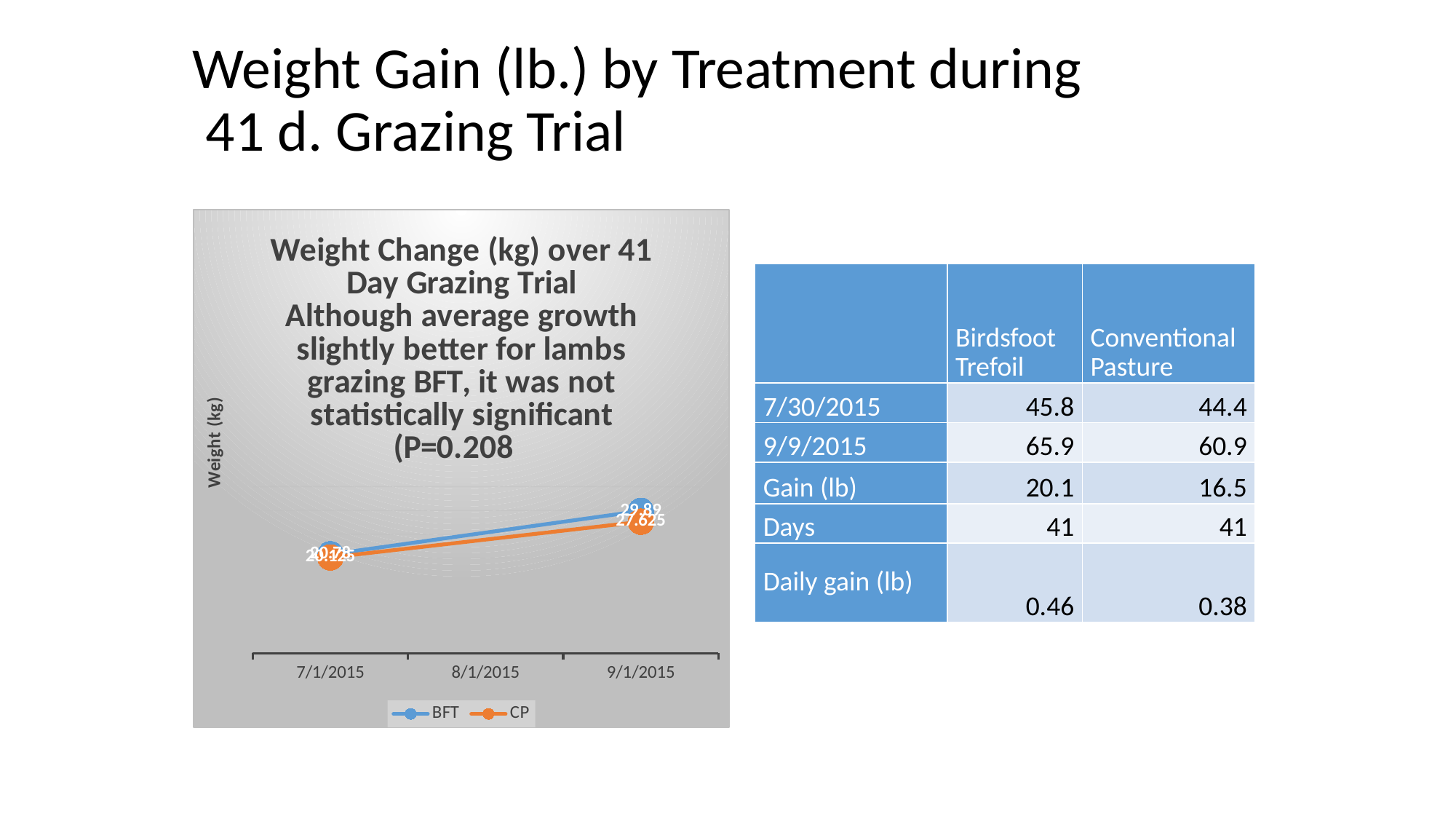
What is the difference between the BFT and CP values at the final data point? 2.265 What kind of chart is shown on the slide? line chart What are the two series named in the chart legend? BFT and CP What is the value of the CP series at its final (September) data point? 27.625 Do the values of the BFT series rise or fall from the first point to the last point? rise How many data points are plotted for each series in the chart? 2 At the final data point, which series has the higher value, BFT or CP? BFT Which series reaches the highest value on the chart? BFT How many series does the chart legend list? 2 What is the value of the BFT series at its final (September) data point? 29.89 What is the label on the chart's vertical axis? Weight (kg) Do the values of the CP series rise or fall along the x axis? rise